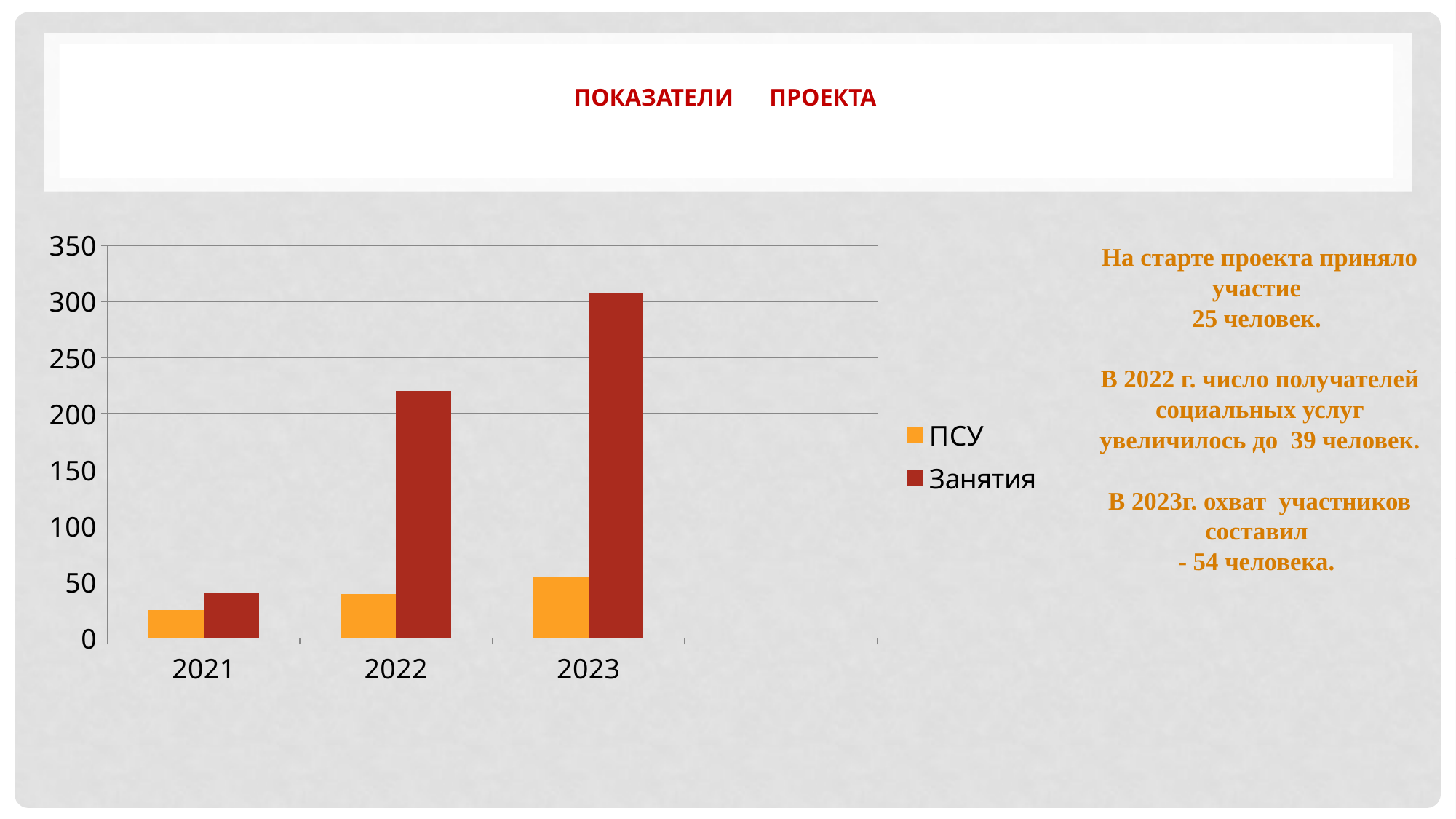
Is the value for ПСУ in 2021 greater or less than 50? less In 2022, which is larger: ПСУ or Занятия? Занятия Which series are listed in the chart legend? ПСУ and Занятия In which year is the Занятия bar the highest? 2023 Is the value for Занятия in 2022 greater or less than 200? greater Do the Занятия values rise or fall from 2021 to 2023? rise In which year is the Занятия bar the lowest? 2021 Is the value for Занятия in 2023 greater or less than 250? greater What kind of chart is shown on the slide? bar chart In which year is the ПСУ bar the highest? 2023 How many years are shown on the x axis of the chart? 3 How many series does the chart legend list? 2